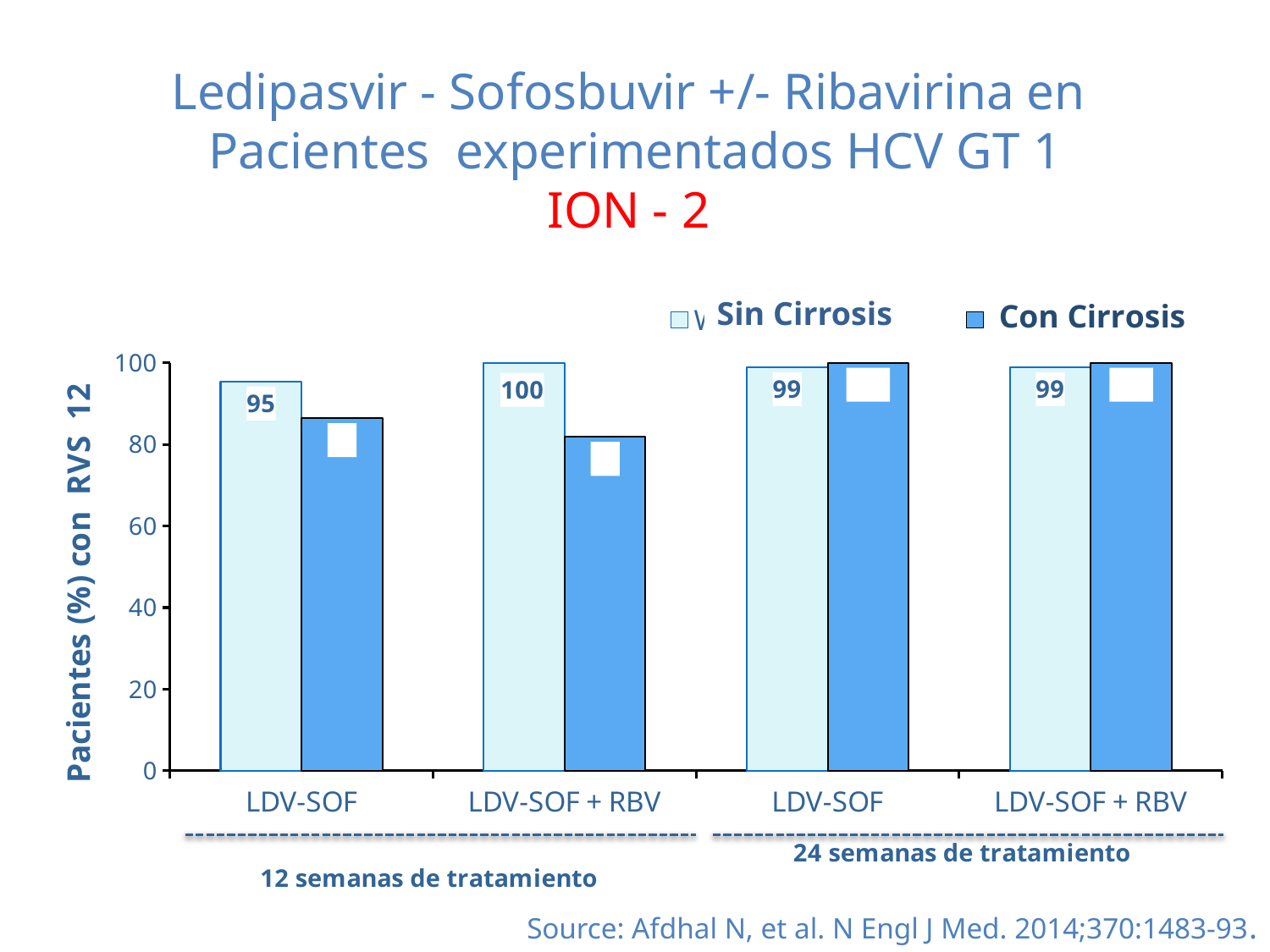
For LDV-SOF in the 12 semanas de tratamiento group, which series has the larger value, Sin Cirrosis or Con Cirrosis? Sin Cirrosis Is the Con Cirrosis value for LDV-SOF + RBV in the 12 semanas de tratamiento group greater or less than 100? less How many series does the legend list? 2 What is the difference between the Sin Cirrosis values for LDV-SOF + RBV and LDV-SOF in the 12 semanas de tratamiento group? 5 What is the value for Sin Cirrosis for LDV-SOF + RBV in the 12 semanas de tratamiento group? 100 Is the Con Cirrosis value for LDV-SOF in the 12 semanas de tratamiento group greater or less than 80? greater What is the value for Sin Cirrosis for LDV-SOF in the 24 semanas de tratamiento group? 99 Which category has the highest Sin Cirrosis value? LDV-SOF + RBV (12 semanas de tratamiento) What is the value for Sin Cirrosis for LDV-SOF in the 12 semanas de tratamiento group? 95 What is the label of the vertical axis? Pacientes (%) con RVS 12 What kind of chart is shown on the slide? bar chart Which category has the lowest Sin Cirrosis value? LDV-SOF (12 semanas de tratamiento)